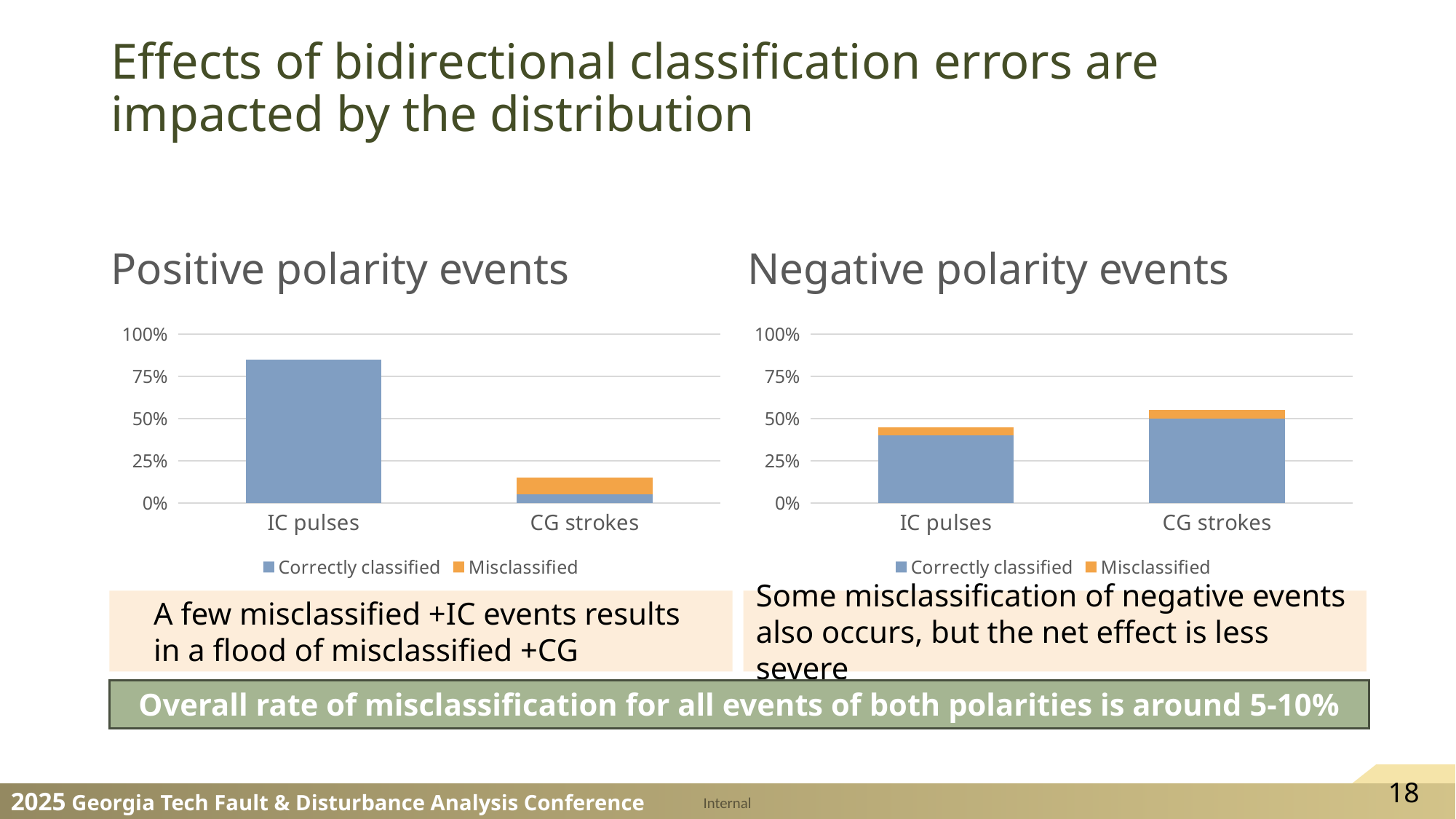
In the Negative polarity events chart, is the total stacked bar for IC pulses greater or less than 50%? less In the Positive polarity events chart, which category has the taller total bar, IC pulses or CG strokes? IC pulses In the Negative polarity events chart, is the total stacked bar for CG strokes greater or less than 50%? greater How many series does the legend of the Positive polarity events chart list? 2 In the Positive polarity events chart, which category has the larger Misclassified segment, IC pulses or CG strokes? CG strokes In the Positive polarity events chart, is the Correctly classified value for IC pulses greater or less than 75%? greater What kind of chart is the Positive polarity events chart? bar chart How many categories are shown on the x axis of the Negative polarity events chart? 2 What colour represents the Misclassified series in the charts? orange In the Negative polarity events chart, which category has the taller total bar, IC pulses or CG strokes? CG strokes